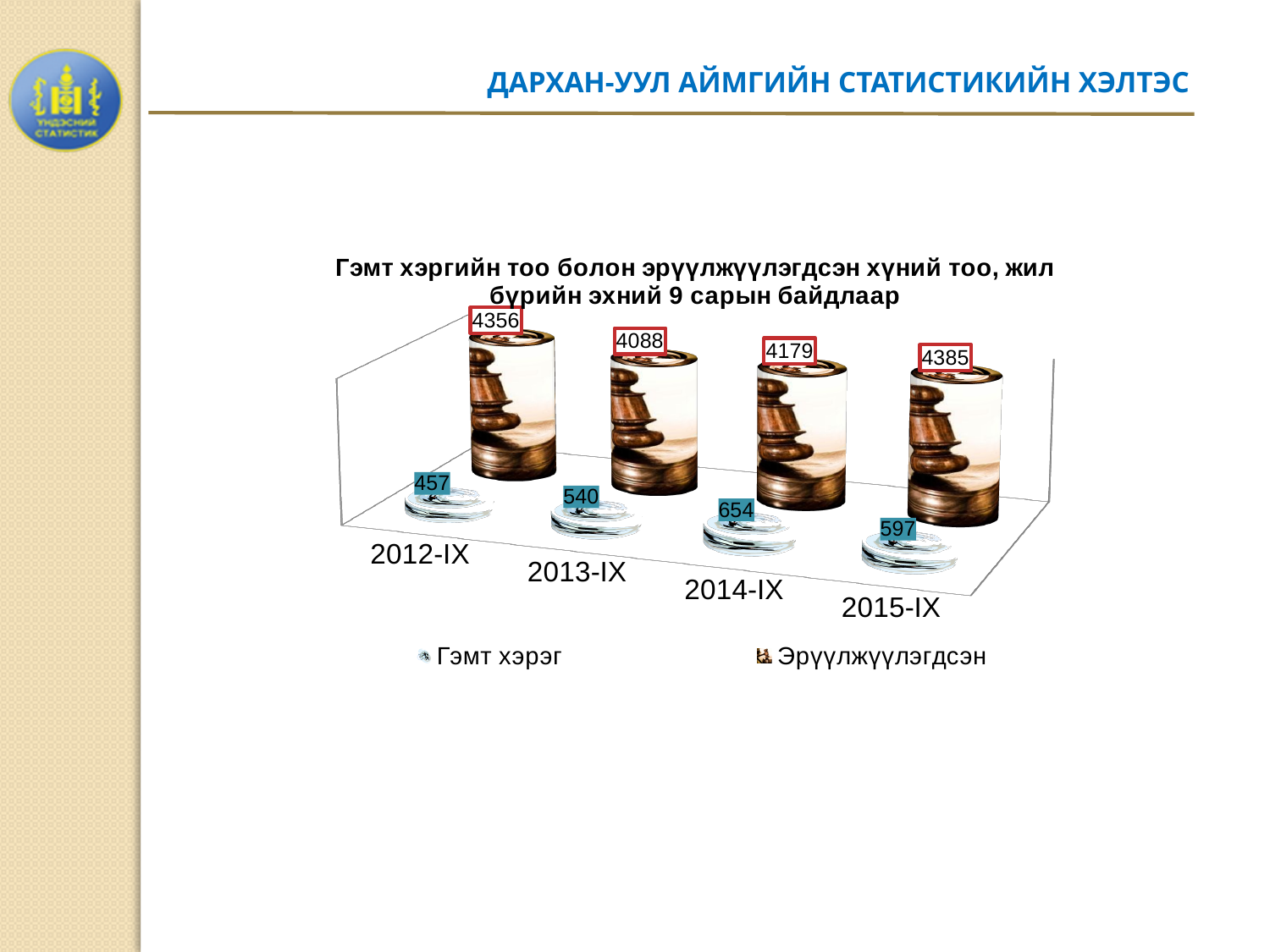
What kind of chart is shown on the slide? Bar chart Which is larger, the Гэмт хэрэг value for 2015-IX or for 2013-IX? 2015-IX What is the value for Гэмт хэрэг in 2014-IX? 654 How many years are shown on the x axis? 4 How many series does the legend list? 2 What is the difference between the Гэмт хэрэг values for 2014-IX and 2012-IX? 197 What is the value for Гэмт хэрэг in 2013-IX? 540 What is the value for Эрүүлжүүлэгдсэн in 2015-IX? 4385 In which year is the Гэмт хэрэг value highest? 2014-IX What is the value for Эрүүлжүүлэгдсэн in 2012-IX? 4356 What is the difference between the Эрүүлжүүлэгдсэн values for 2015-IX and 2013-IX? 297 In which year is the Эрүүлжүүлэгдсэн value lowest? 2013-IX